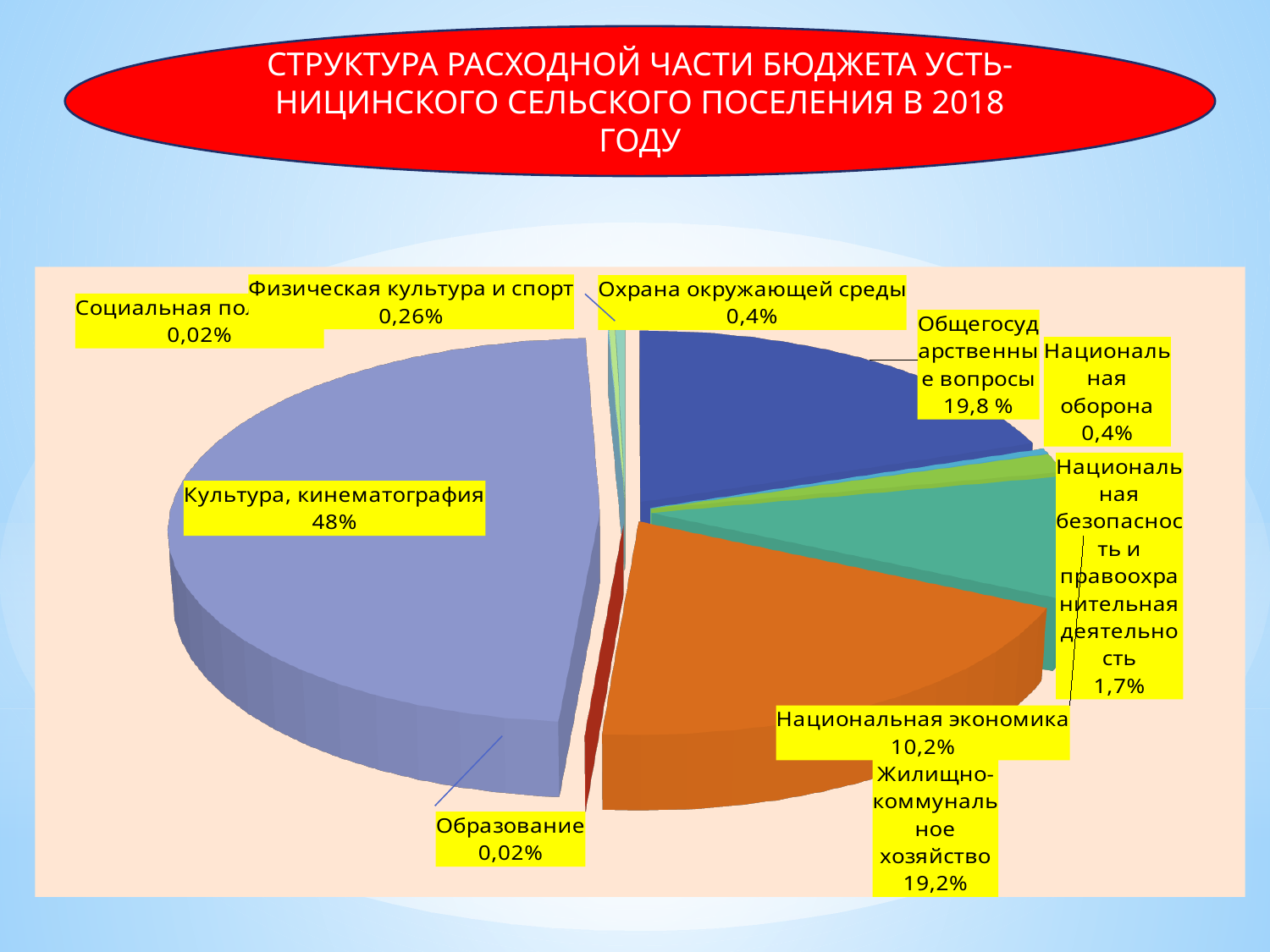
What type of chart is shown on the slide? Pie chart Which category has the largest share of the pie? Культура, кинематография What is the difference between the shares of Культура, кинематография and Общегосударственные вопросы? 28,2% Which is larger: Общегосударственные вопросы or Жилищно-коммунальное хозяйство? Общегосударственные вопросы What share of the budget expenditure goes to Культура, кинематография? 48% What is the value shown for Физическая культура и спорт? 0,26% What is the value shown for Национальная безопасность и правоохранительная деятельность? 1,7% What is the value shown for Национальная экономика? 10,2% What is the value shown for Жилищно-коммунальное хозяйство? 19,2% Which year does the budget expenditure structure in the slide title refer to? 2018 How many categories are shown in the pie chart? 10 What is the value shown for Общегосударственные вопросы? 19,8 %